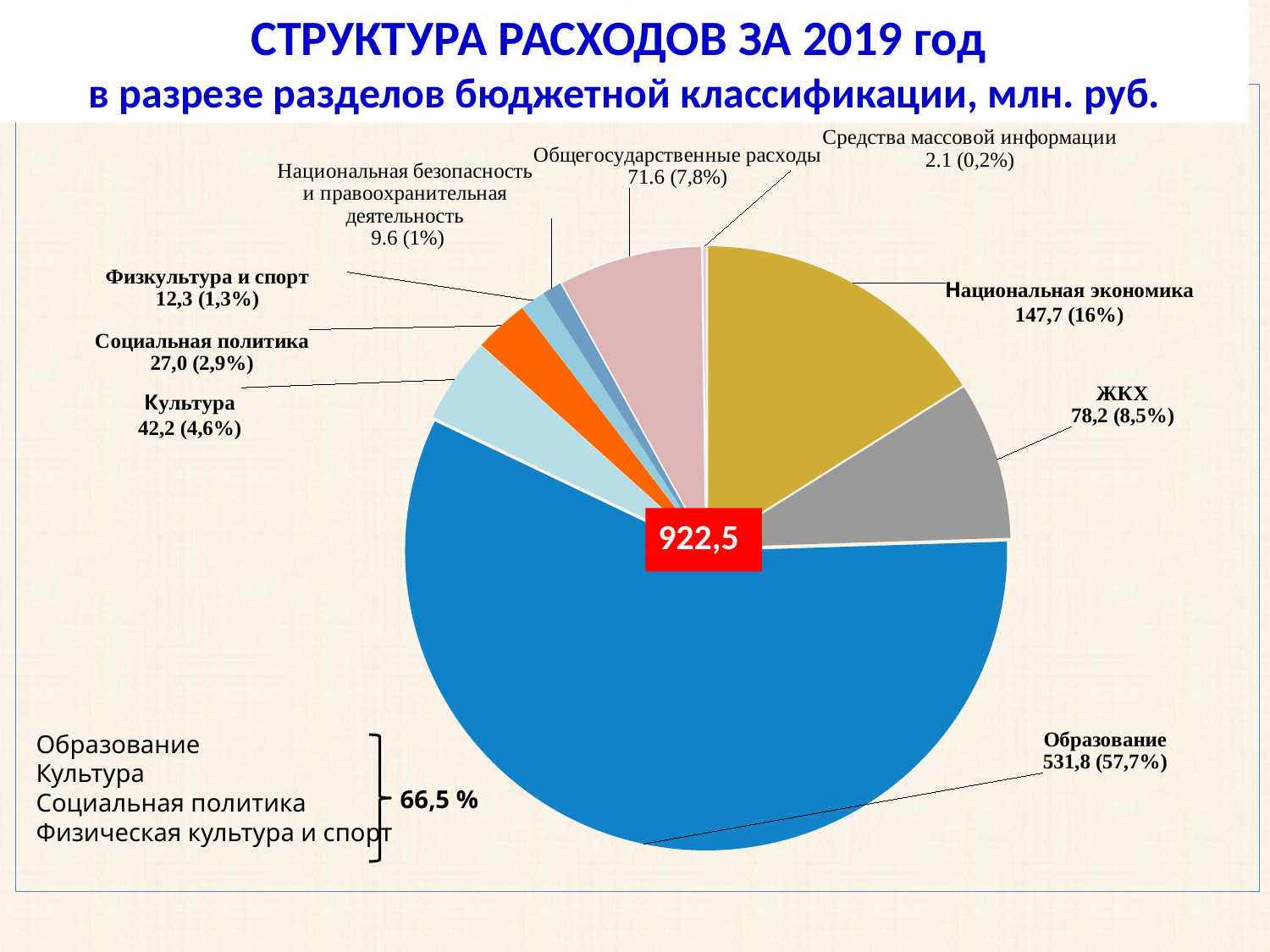
How many slices does the pie chart have? 9 What is the difference between Национальная экономика (147,7) and ЖКХ (78,2)? 69,5 What kind of chart is shown on the slide? pie chart What is the value for Национальная экономика? 147,7 (16%) What is the value for Образование? 531,8 (57,7%) Which category has the smallest slice? Средства массовой информации Which is larger, Культура or Социальная политика? Культура Which category has the largest slice? Образование What total value is shown in the centre of the pie chart? 922,5 What share of the pie does Общегосударственные расходы take? 7,8% What combined share is shown for Образование, Культура, Социальная политика and Физическая культура и спорт? 66,5 % What is the value for ЖКХ? 78,2 (8,5%)